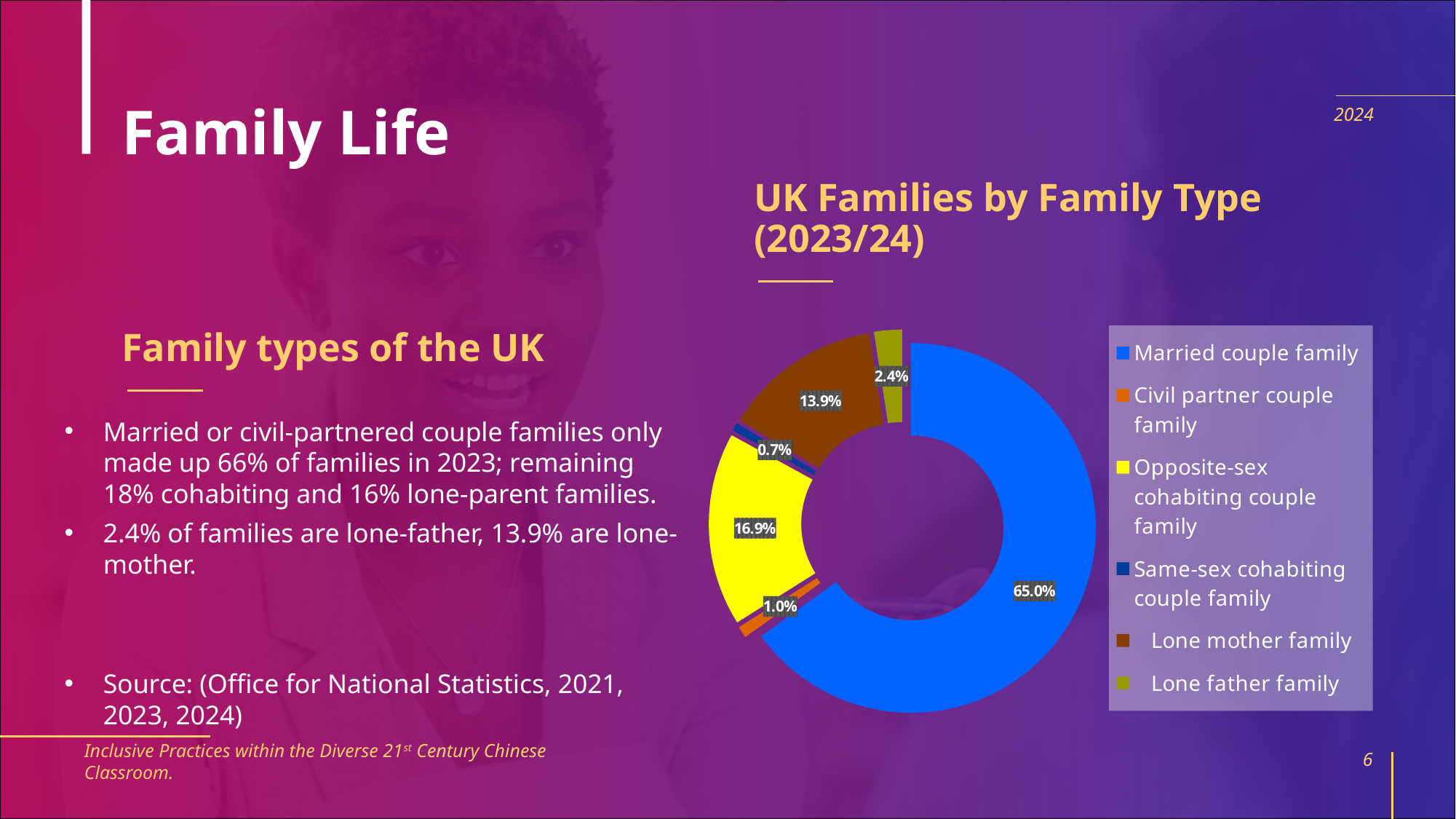
What kind of chart is used to show UK families by family type? Doughnut chart What percentage of UK families are married couple families according to the chart? 65.0% What percentage is shown for Opposite-sex cohabiting couple family? 16.9% Which is larger: the Opposite-sex cohabiting couple family share or the Lone mother family share? Opposite-sex cohabiting couple family What value is labelled for the Same-sex cohabiting couple family slice? 0.7% How many family types are shown in the chart? 6 What is the difference in percentage points between the Lone mother family and Lone father family slices? 11.5 What is the title of the chart on the slide? UK Families by Family Type (2023/24) Which family type has the smallest share in the chart? Same-sex cohabiting couple family What is the combined share of the Lone mother family and Lone father family slices? 16.3% Which family type has the largest share in the chart? Married couple family What is the value shown for the Lone mother family slice? 13.9%